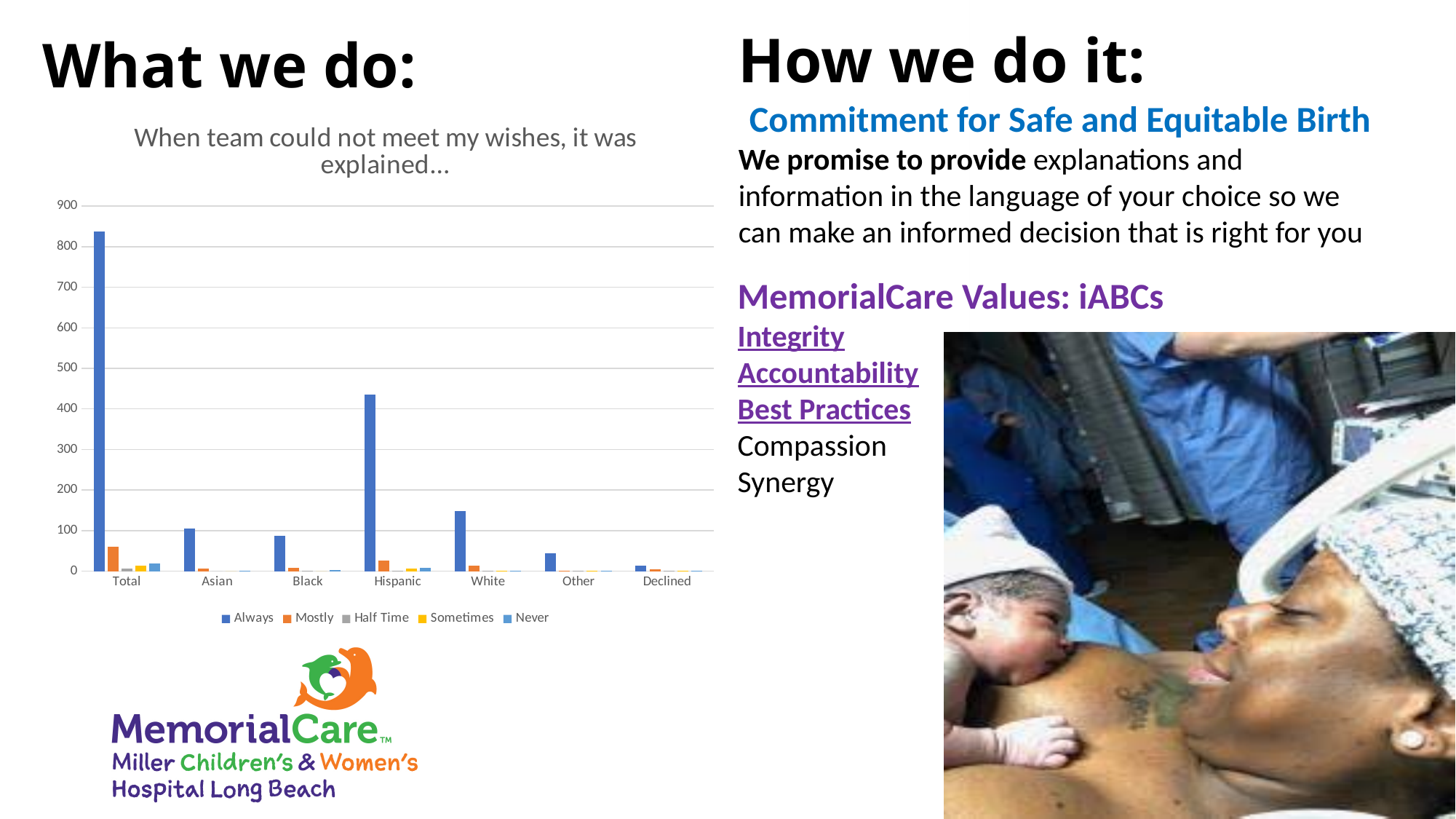
Is the 'Always' value for Black greater or less than 100? less Which category has the highest 'Always' bar? Total How many categories are shown on the x axis of the chart? 7 What kind of chart is shown on the slide? bar chart How many series does the chart legend list? 5 Which category has the lowest 'Always' bar? Declined What is the title of the chart? When team could not meet my wishes, it was explained... Is the 'Mostly' value for Total greater or less than 100? less Is the 'Always' value for Total greater or less than 800? greater Which has the larger 'Always' value, Hispanic or White? Hispanic Which series is shown in orange in the chart legend? Mostly